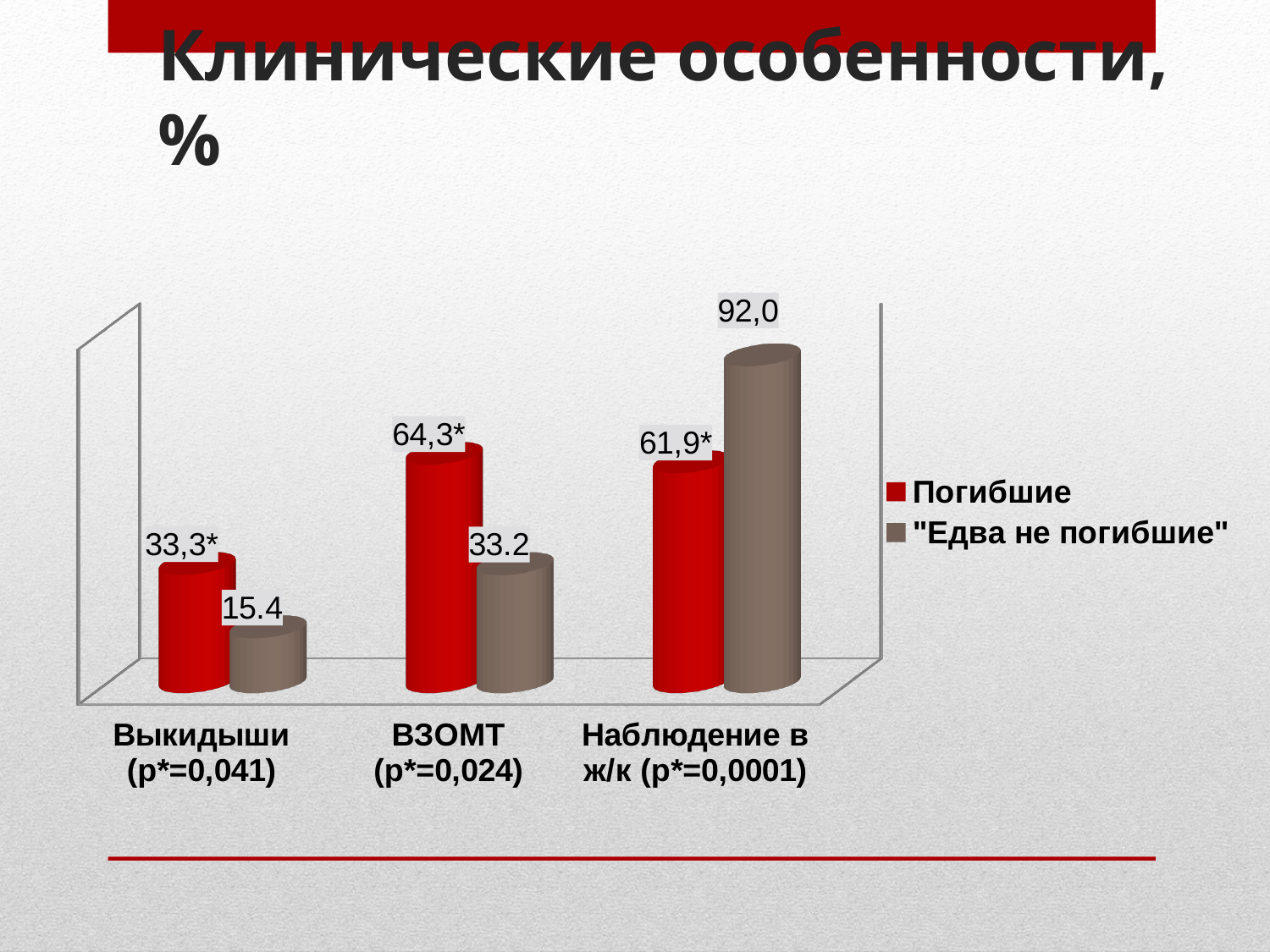
In the ВЗОМТ category, which series has the larger value, Погибшие or "Едва не погибшие"? Погибшие What is the value for "Едва не погибшие" in the Выкидыши category? 15.4 What is the value for Погибшие in the Выкидыши category? 33,3* Which category has the lowest value for Погибшие? Выкидыши (p*=0,041) What type of chart is shown on the slide? Bar chart What is the value for Погибшие in the ВЗОМТ category? 64,3* What is the value for "Едва не погибшие" in the Наблюдение в ж/к category? 92,0 Which category has the highest value for "Едва не погибшие"? Наблюдение в ж/к (p*=0,0001) How many series does the legend list? 2 How many categories are shown on the x axis? 3 What is the difference between the "Едва не погибшие" and Погибшие values in the Наблюдение в ж/к category? 30,1 What colour are the bars for the Погибшие series? Red